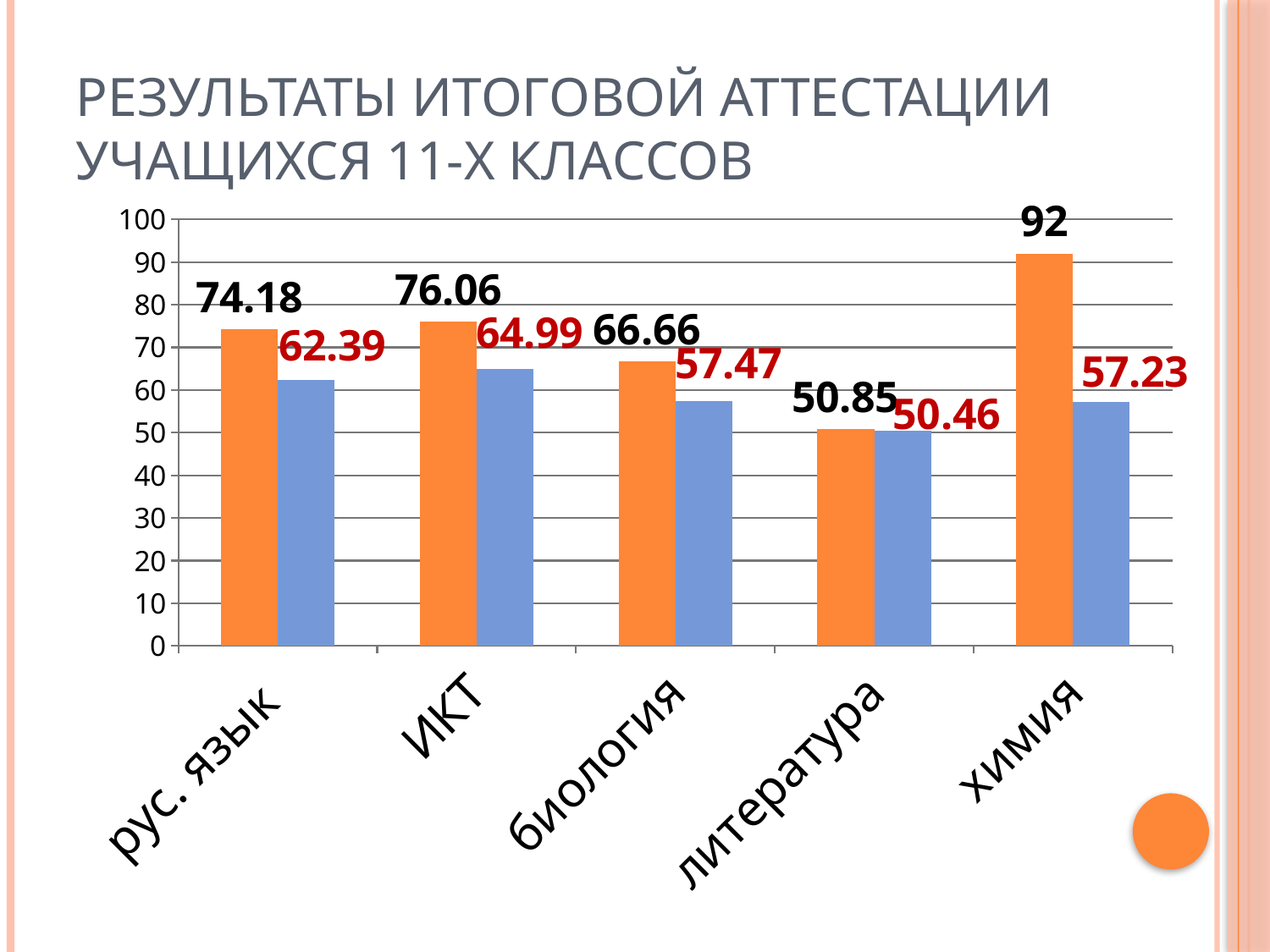
Which category has the lowest blue bar? литература Which category has the highest orange bar? химия Which is larger: the orange bar for ИКТ or the orange bar for рус. язык? ИКТ What is the value of the blue bar for ИКТ? 64.99 What is the difference between the orange and blue bars for биология? 9.19 What is the difference between the orange bar for химия and the orange bar for литература? 41.15 What is the value of the orange bar for литература? 50.85 What is the value of the blue bar for рус. язык? 62.39 Is the blue bar for химия greater or less than 60? less What is the value of the orange bar for химия? 92 How many categories are shown on the x axis? 5 What kind of chart is shown on the slide? bar chart